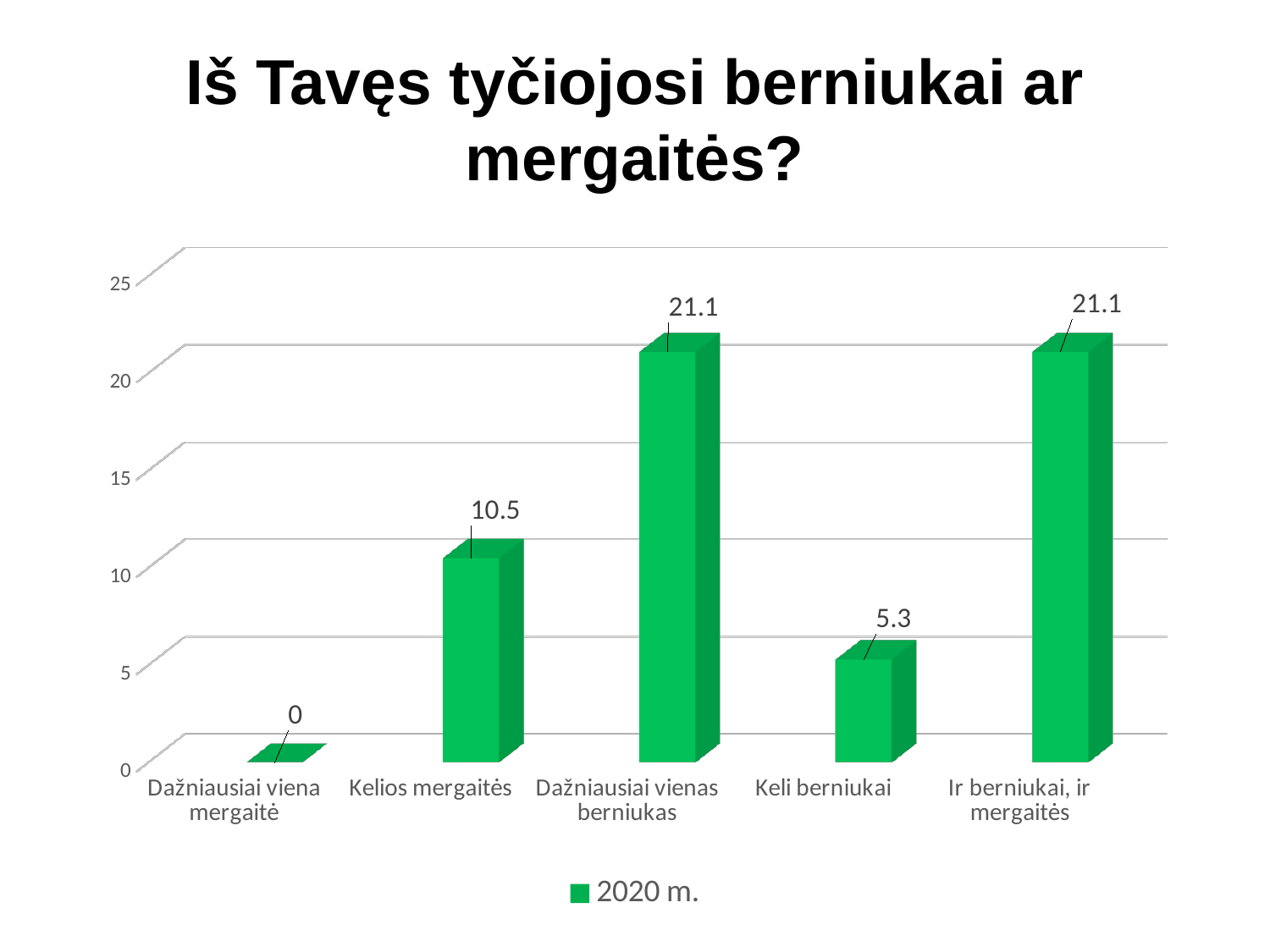
What is the difference between the values for "Dažniausiai vienas berniukas" and "Kelios mergaitės"? 10.6 What is the value for "Ir berniukai, ir mergaitės"? 21.1 What is the value for "Keli berniukai"? 5.3 Which is larger, the value for "Kelios mergaitės" or the value for "Keli berniukai"? Kelios mergaitės What is the value for "Dažniausiai viena mergaitė"? 0 How many categories are shown on the x axis? 5 How many series does the legend list? 1 Is the value for "Dažniausiai vienas berniukas" greater or less than 20? greater What kind of chart is shown on the slide? bar chart What is the difference between the values for "Kelios mergaitės" and "Keli berniukai"? 5.2 Which category has the lowest value? Dažniausiai viena mergaitė What is the value for "Kelios mergaitės"? 10.5